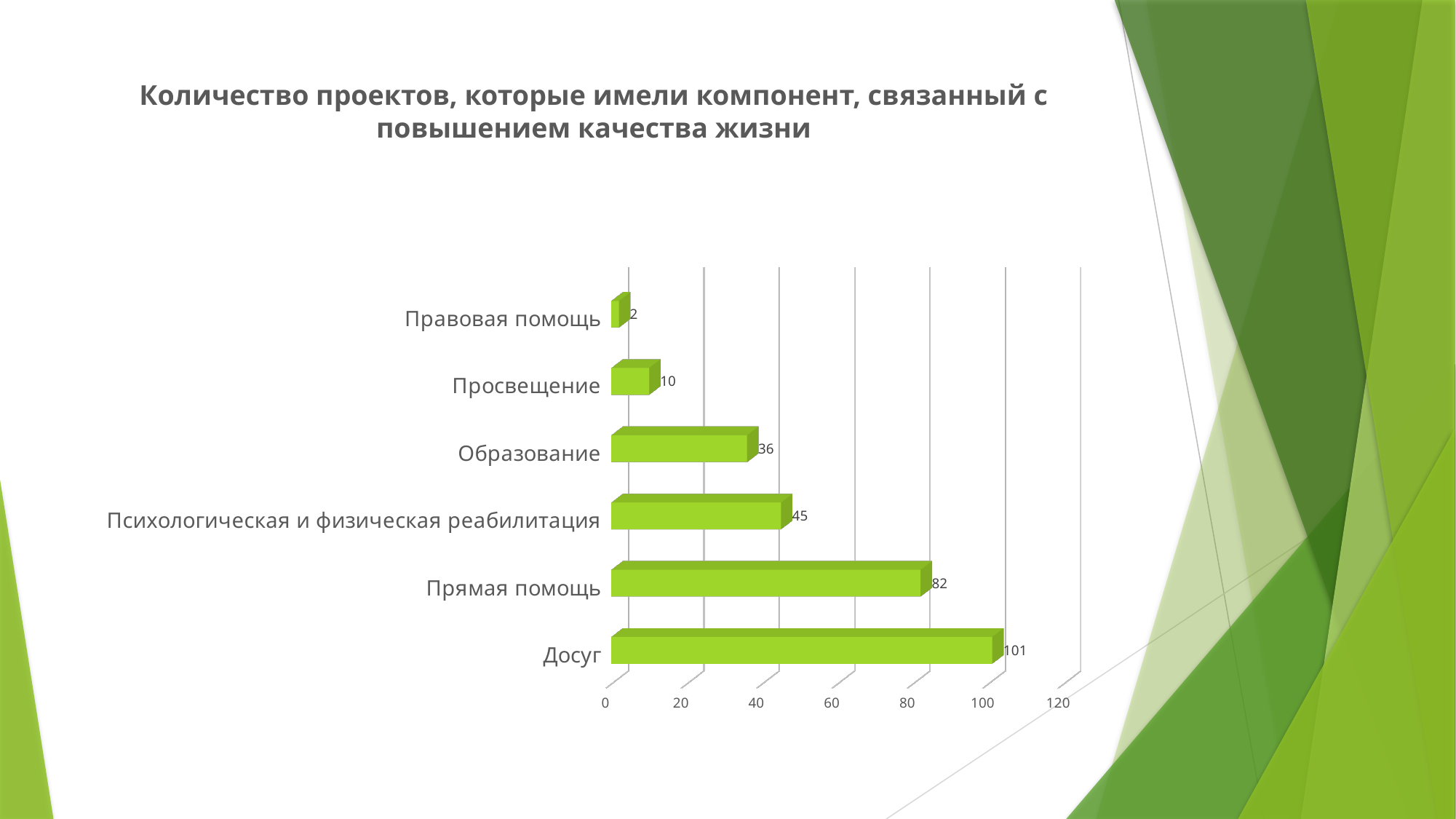
What is the value for Просвещение? 10 Which category has the highest value? Досуг What is the value for Прямая помощь? 82 What is the value for Образование? 36 What kind of chart is shown on the slide? bar chart Which is larger, the value for Образование or the value for Психологическая и физическая реабилитация? Психологическая и физическая реабилитация What is the value for Досуг? 101 Which category has the lowest value? Правовая помощь What is the value for Психологическая и физическая реабилитация? 45 What is the difference between the values for Досуг and Прямая помощь? 19 Is the value for Прямая помощь greater or less than 60? greater How many categories are shown in the chart? 6